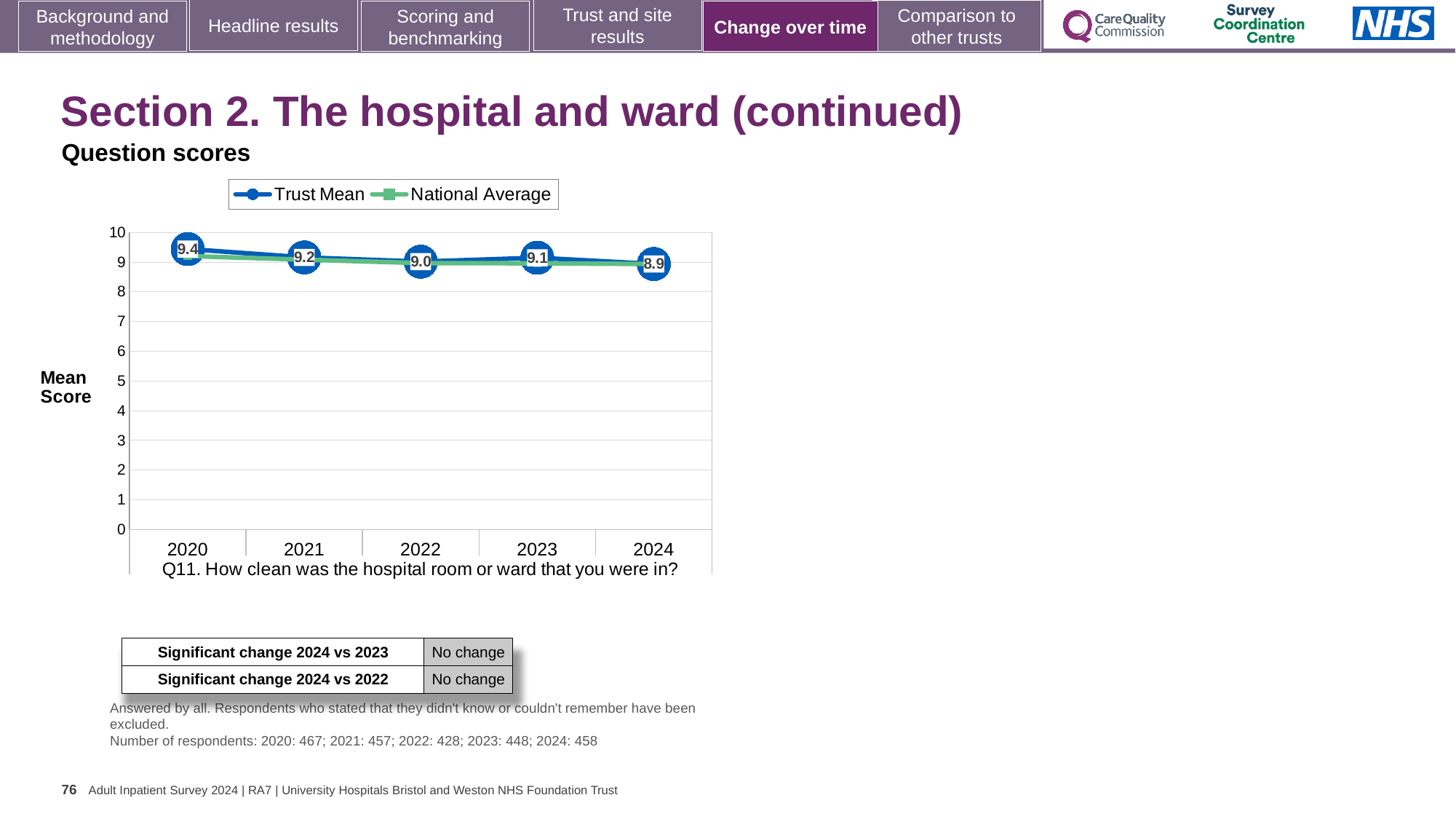
Which question does the chart show scores for? Q11. How clean was the hospital room or ward that you were in? What is the Trust Mean score for 2024? 8.9 How many years are shown on the x axis of the chart? 5 What is the Trust Mean score for 2022? 9.0 What is the Trust Mean score for 2020? 9.4 What is the difference between the Trust Mean score in 2020 and in 2024? 0.5 In which year is the Trust Mean score lowest? 2024 How many series does the chart legend list? 2 What kind of chart is shown on the slide? line chart In which year is the Trust Mean score highest? 2020 Is the Trust Mean score for 2023 greater or less than 8? greater Which is larger, the Trust Mean score for 2021 or for 2023? 2021